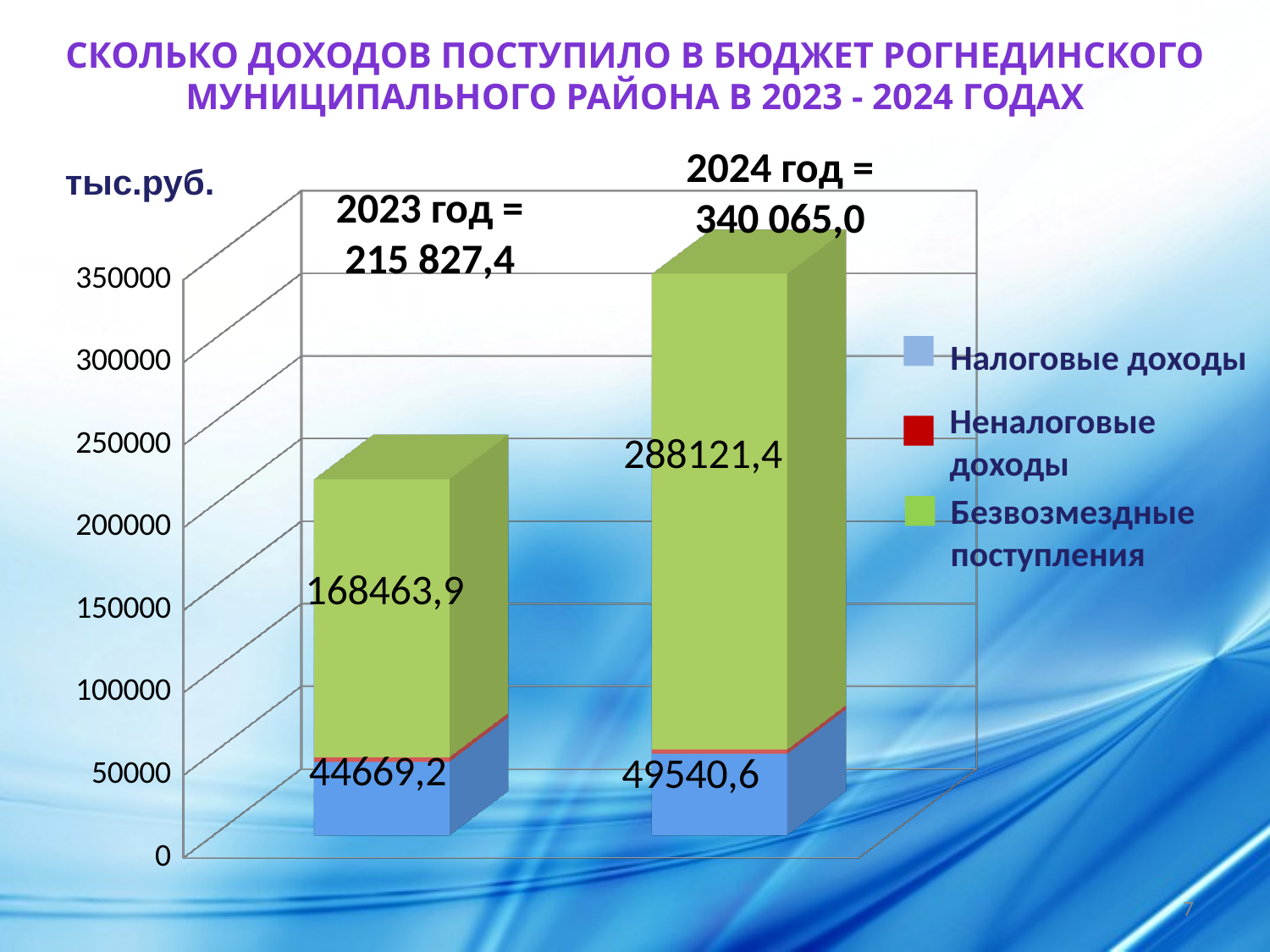
What is the total income shown for 2023? 215 827,4 What is the value of Безвозмездные поступления for 2023? 168463,9 What unit of measurement is indicated for the chart values? тыс.руб. Is the total bar for 2024 greater or less than 300000? greater What is the value of Безвозмездные поступления for 2024? 288121,4 What is the value of Налоговые доходы for 2023? 44669,2 Which year has the larger value of Налоговые доходы, 2023 or 2024? 2024 By how much did Безвозмездные поступления increase from 2023 to 2024? 119657,5 How many series does the legend list? 3 What is the total income shown for 2024? 340 065,0 How many years (bars) are plotted in the chart? 2 What kind of chart is shown on the slide? stacked bar chart